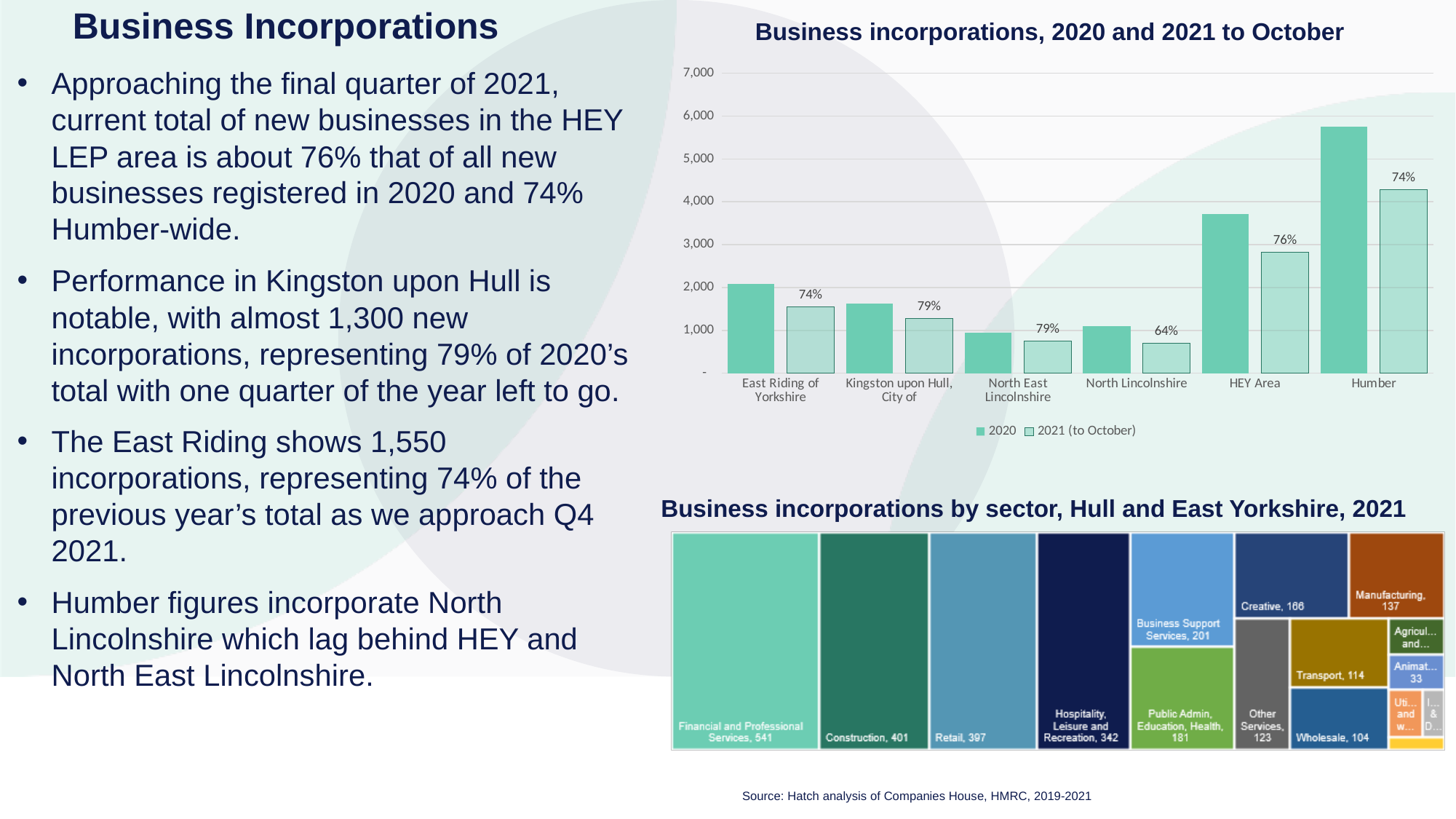
In the chart 'Business incorporations, 2020 and 2021 to October', is the 2020 value for HEY Area greater or less than 3,000? greater In the chart 'Business incorporations, 2020 and 2021 to October', what percentage label is shown on the 2021 (to October) bar for Kingston upon Hull, City of? 79% In the chart 'Business incorporations, 2020 and 2021 to October', what percentage label is shown on the 2021 (to October) bar for North Lincolnshire? 64% In the chart 'Business incorporations by sector, Hull and East Yorkshire, 2021', what is the difference between the Construction and Retail values? 4 In the chart 'Business incorporations by sector, Hull and East Yorkshire, 2021', which sector has the largest number of incorporations? Financial and Professional Services In the chart 'Business incorporations, 2020 and 2021 to October', how many series does the legend list? 2 In the chart 'Business incorporations, 2020 and 2021 to October', is the 2020 value for Humber greater or less than 5,000? greater In the chart 'Business incorporations by sector, Hull and East Yorkshire, 2021', how many incorporations are shown for Construction? 401 What kind of chart is 'Business incorporations, 2020 and 2021 to October'? Bar chart In the chart 'Business incorporations, 2020 and 2021 to October', how many areas are shown on the x axis? 6 In the chart 'Business incorporations, 2020 and 2021 to October', which area has the lowest percentage label on its 2021 (to October) bar? North Lincolnshire In the chart 'Business incorporations, 2020 and 2021 to October', which area has the tallest 2020 bar? Humber